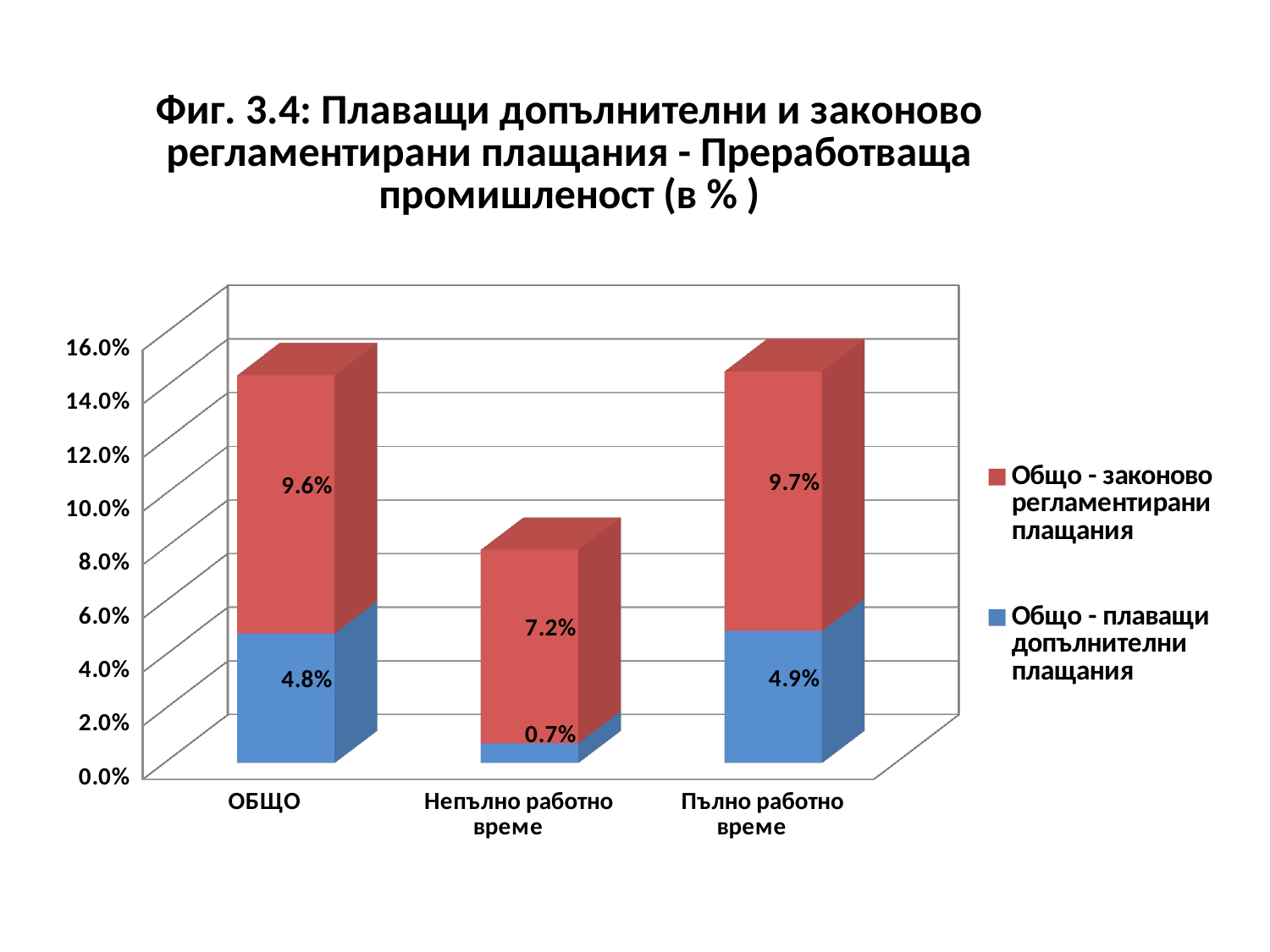
What is the value of Общо - законово регламентирани плащания for Пълно работно време? 9.7% What is the total of the stacked bar for Непълно работно време? 7.9% Which category has the lowest value for Общо - плаващи допълнителни плащания? Непълно работно време What is the difference between Общо - законово регламентирани плащания and Общо - плаващи допълнителни плащания for Непълно работно време? 6.5% What is the total of the stacked bar for ОБЩО? 14.4% What is the value of Общо - плаващи допълнителни плащания for Пълно работно време? 4.9% What is the value of Общо - законово регламентирани плащания for Непълно работно време? 7.2% Which category has the lowest value for Общо - законово регламентирани плащания? Непълно работно време How many categories are shown on the x axis? 3 Is the value of Общо - законово регламентирани плащания larger for ОБЩО or for Непълно работно време? ОБЩО What is the value of Общо - плаващи допълнителни плащания for ОБЩО? 4.8% What kind of chart is shown on the slide? Stacked bar chart